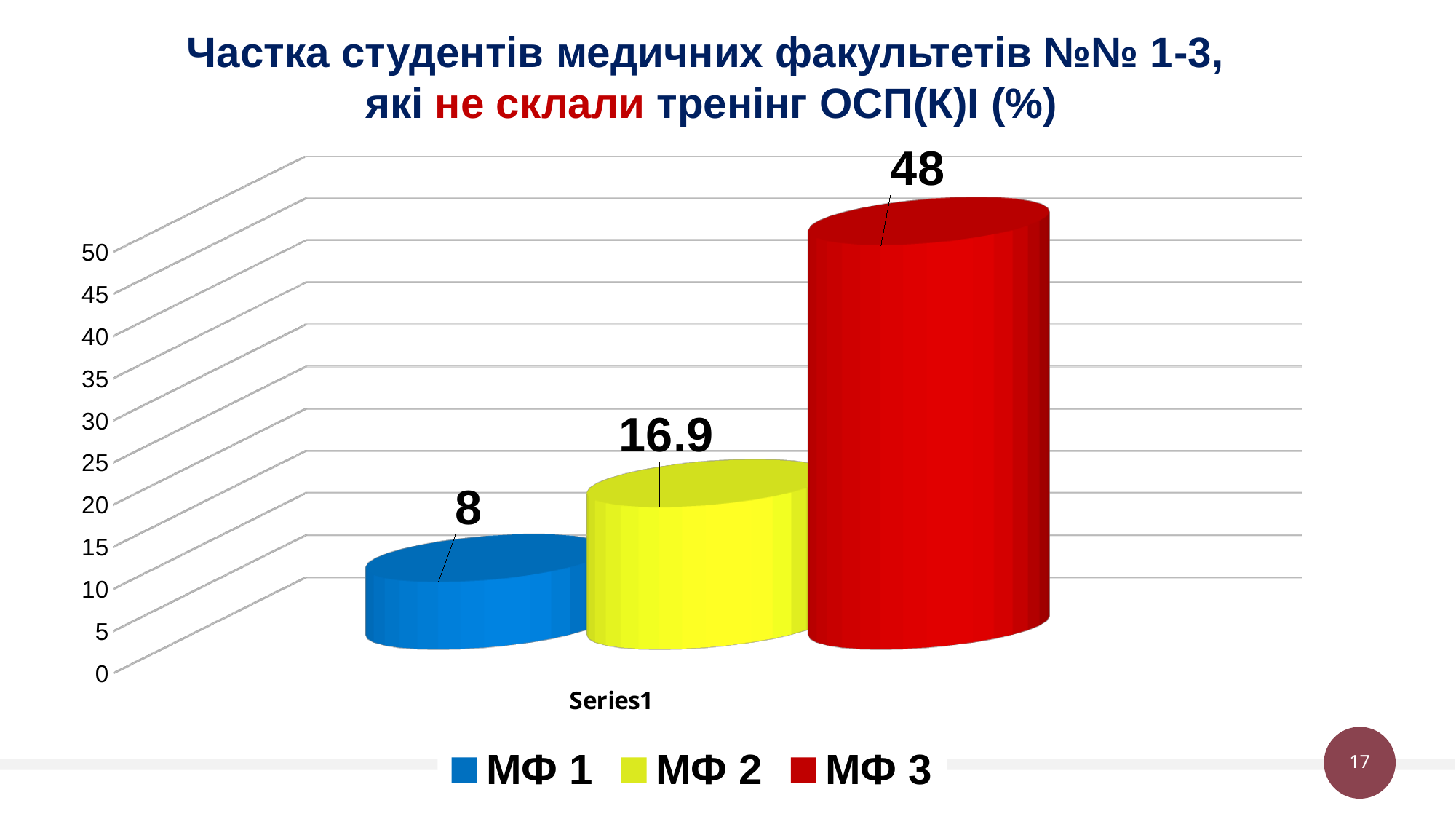
Which faculty has the lowest share of students who did not pass the training? МФ 1 What is the value for МФ 2? 16.9 What is the value for МФ 3? 48 What kind of chart is shown on the slide? bar chart What is the difference between the values for МФ 3 and МФ 1? 40 How many series does the legend list? 3 Is the value for МФ 3 greater or less than 40? greater Which faculty has the highest share of students who did not pass the training? МФ 3 What colour is the bar for МФ 3? red Which is larger, the value for МФ 2 or the value for МФ 3? МФ 3 What is the value for МФ 1? 8 What is the difference between the values for МФ 2 and МФ 1? 8.9